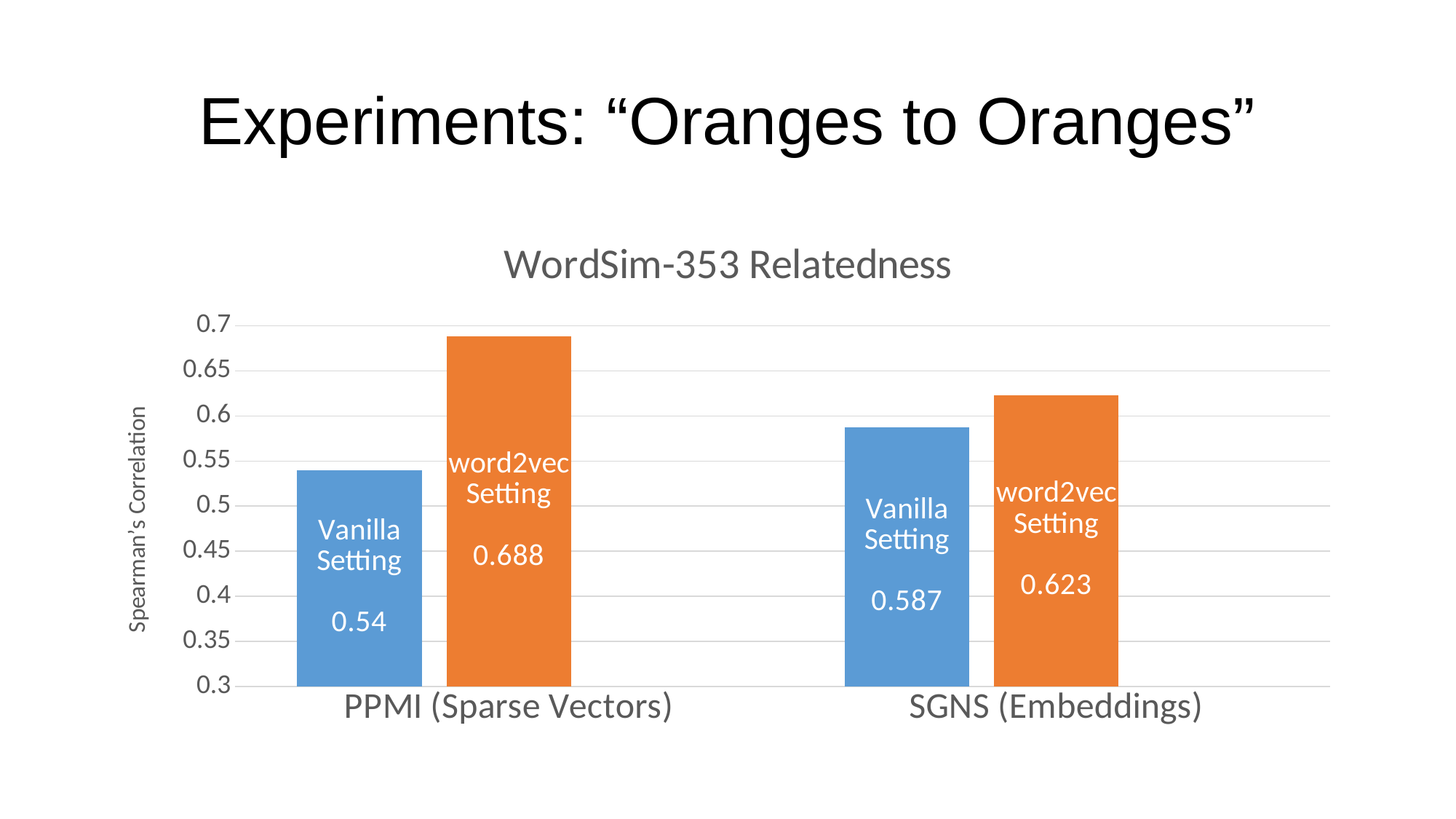
What is the difference between the word2vec Setting and Vanilla Setting values for SGNS (Embeddings)? 0.036 What is the Spearman's Correlation for the word2vec Setting under PPMI (Sparse Vectors)? 0.688 What is the Spearman's Correlation for the word2vec Setting under SGNS (Embeddings)? 0.623 Which is larger: the Vanilla Setting value for PPMI (Sparse Vectors) or the Vanilla Setting value for SGNS (Embeddings)? Vanilla Setting for SGNS (Embeddings) What kind of chart is shown on the slide? Bar chart Which bar has the lowest Spearman's Correlation in the chart? Vanilla Setting under PPMI (Sparse Vectors) Which bar has the highest Spearman's Correlation in the chart? word2vec Setting under PPMI (Sparse Vectors) What is the title of the chart? WordSim-353 Relatedness What is the Spearman's Correlation for the Vanilla Setting under PPMI (Sparse Vectors)? 0.54 How many categories are shown on the x axis of the chart? 2 What is the Spearman's Correlation for the Vanilla Setting under SGNS (Embeddings)? 0.587 What is the difference between the word2vec Setting and Vanilla Setting values for PPMI (Sparse Vectors)? 0.148